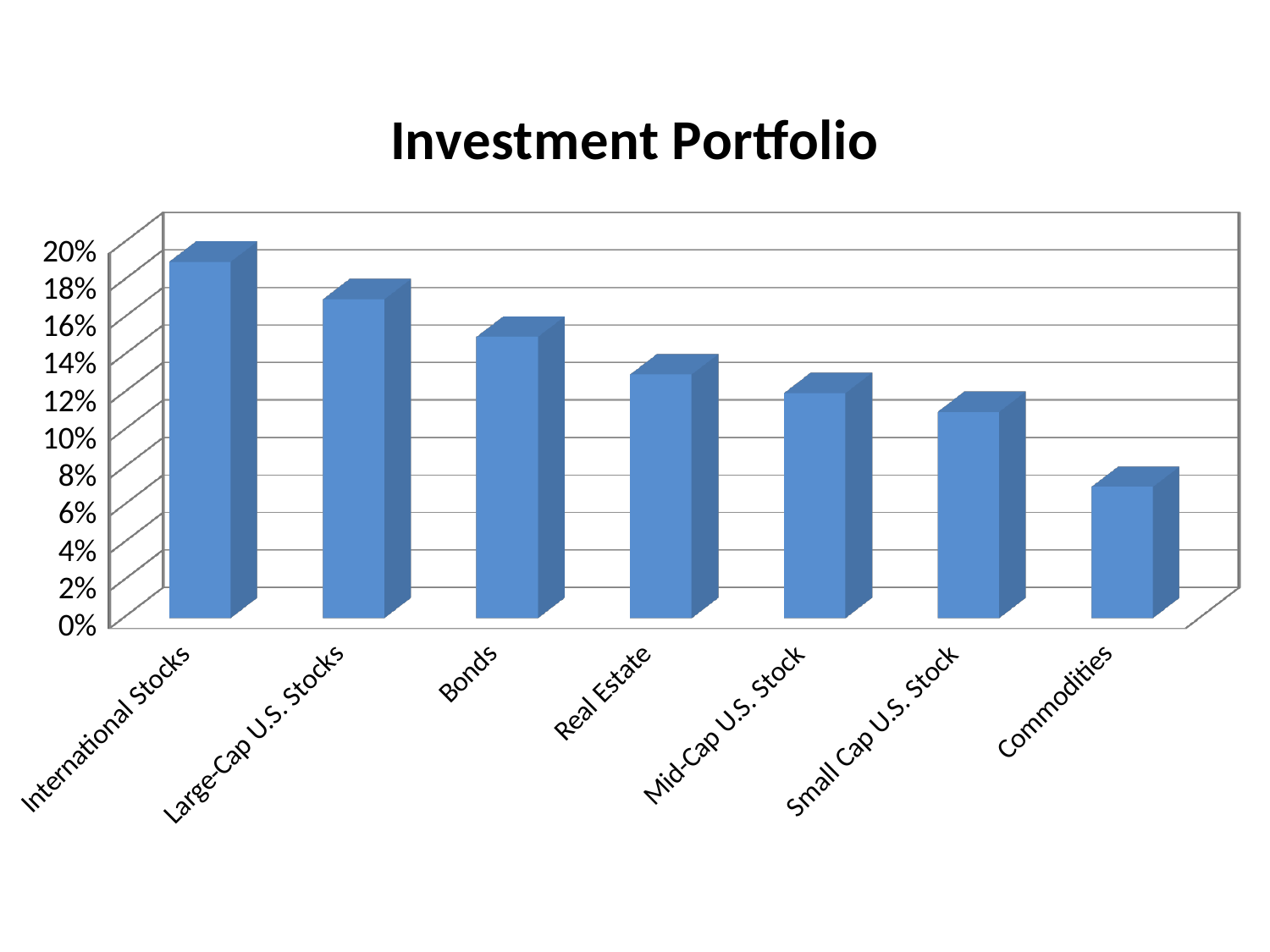
Is the value for Commodities greater or less than 10%? less Which category has the highest value? International Stocks Which is larger, the value for Commodities or the value for Mid-Cap U.S. Stock? Mid-Cap U.S. Stock Which is larger, the value for Large-Cap U.S. Stocks or the value for Real Estate? Large-Cap U.S. Stocks Is the value for International Stocks greater or less than 16%? greater Is the value for Bonds greater or less than 12%? greater How many categories are plotted in the chart? 7 Which category has the lowest value? Commodities Do the values rise or fall moving from left to right along the x axis? Fall What kind of chart is shown on the slide? Bar chart What is the title of the chart? Investment Portfolio